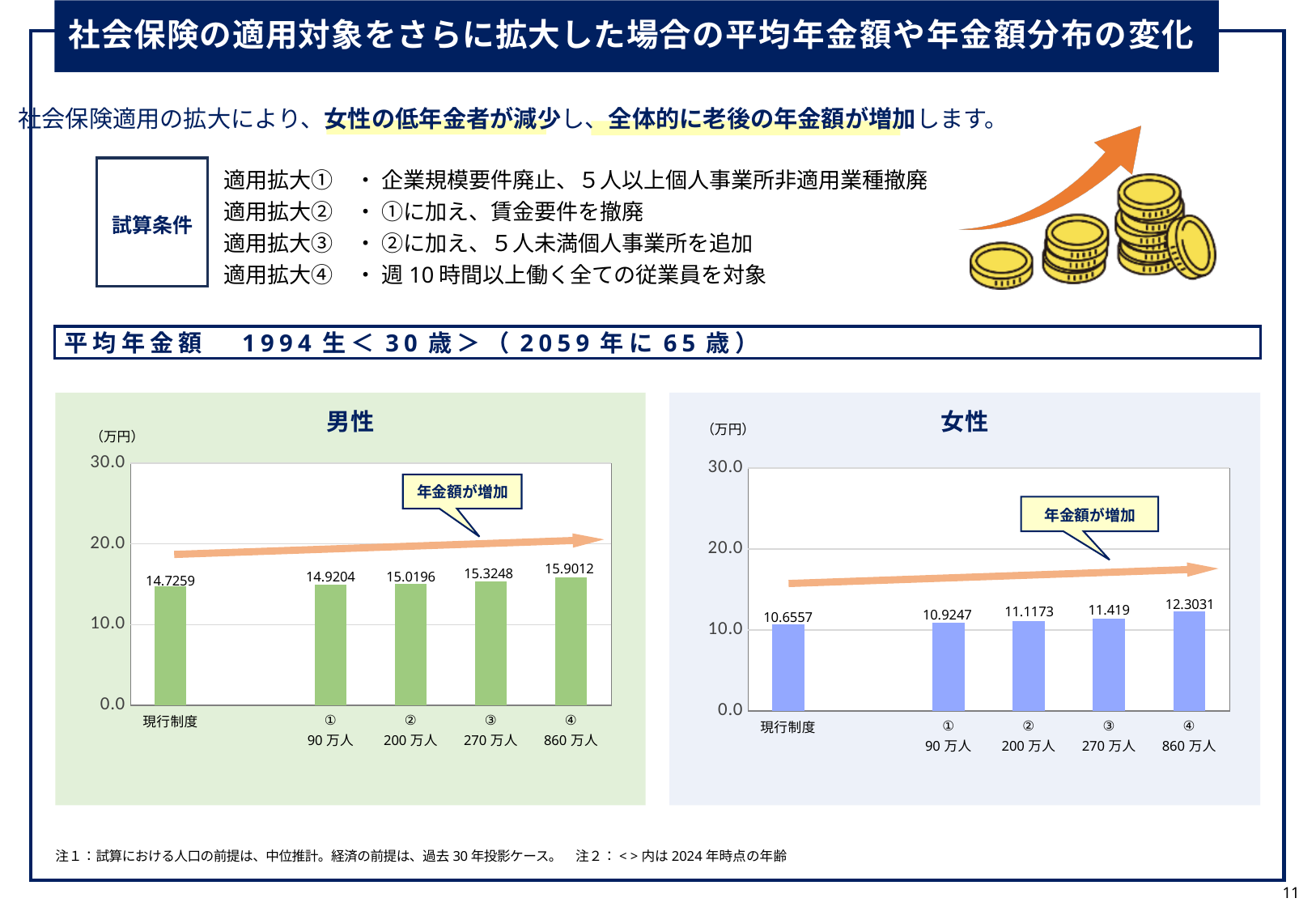
In the 女性 chart, which category has the highest value? ④ In the 男性 chart, what is the difference between the value for ④ and the value for 現行制度? 1.1753 In the 女性 chart, do the values rise or fall from 現行制度 to ④? Rise In the 男性 chart, what is the value for ④? 15.9012 In the 男性 chart, what is the value for 現行制度? 14.7259 In the 女性 chart, what is the difference between the value for ④ and the value for 現行制度? 1.6474 In the 女性 chart, what is the value for ③? 11.419 Which is larger: the value for ② in the 男性 chart or the value for ② in the 女性 chart? 男性 What kind of chart is the 女性 chart? Bar chart In the 男性 chart, how many bars are plotted? 5 In the 男性 chart, which category has the lowest value? 現行制度 In the 女性 chart, what is the value for 現行制度? 10.6557